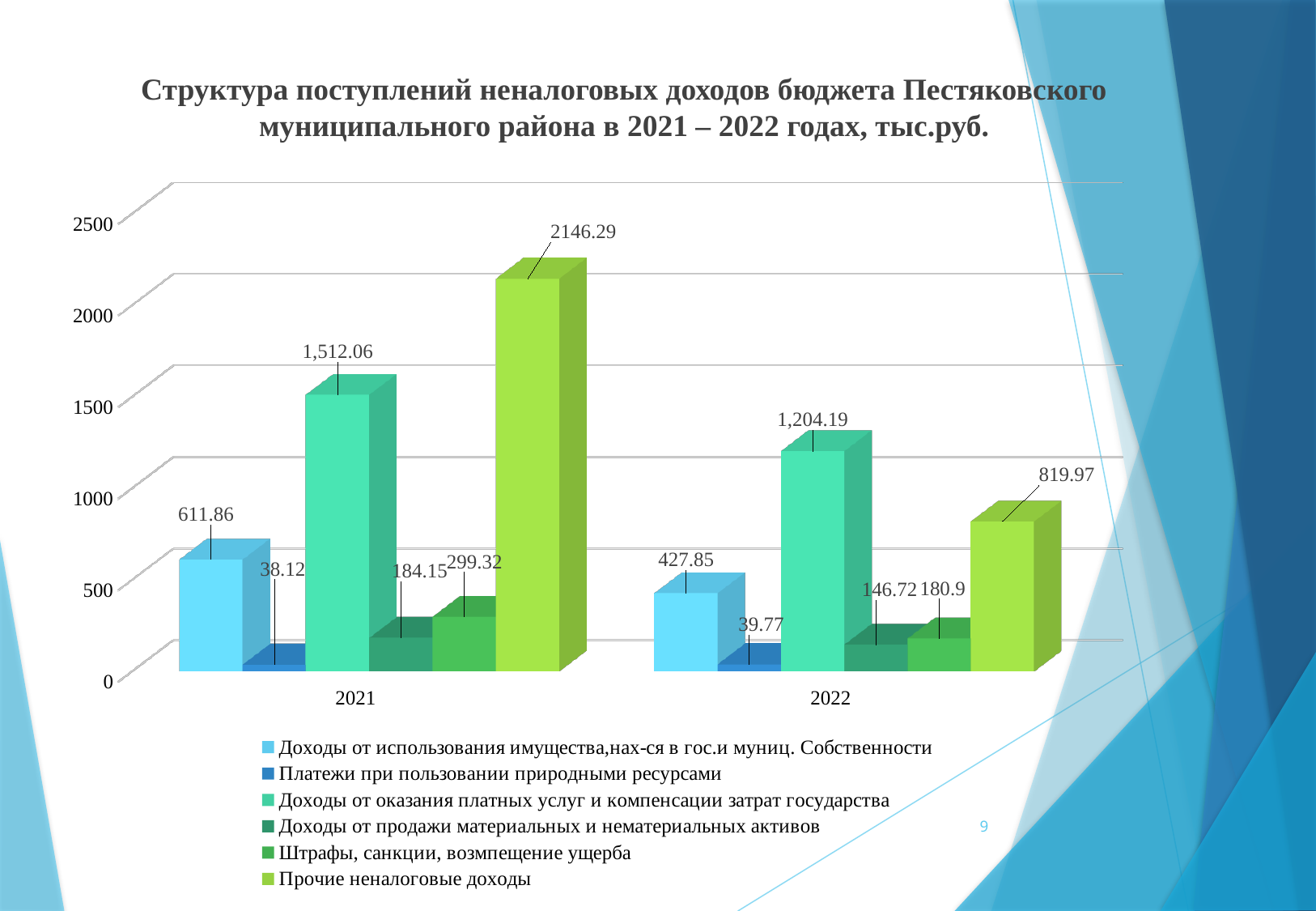
How many series does the legend list? 6 What is the value for "Доходы от оказания платных услуг и компенсации затрат государства" in 2022? 1,204.19 What is the value for "Штрафы, санкции, возмпещение ущерба" in 2022? 180.9 What is the value for "Платежи при пользовании природными ресурсами" in 2021? 38.12 Is the value for "Доходы от оказания платных услуг и компенсации затрат государства" in 2021 greater or less than 1500? greater How many year categories are shown on the x axis? 2 What kind of chart is shown on the slide? Bar chart Which series has the lowest value in 2021? Платежи при пользовании природными ресурсами What is the value for "Прочие неналоговые доходы" in 2021? 2146.29 What is the difference between the 2021 and 2022 values for "Доходы от использования имущества,нах-ся в гос.и муниц. Собственности"? 184.01 Which is larger: the value for "Прочие неналоговые доходы" in 2021 or in 2022? 2021 Which series has the highest value in 2022? Доходы от оказания платных услуг и компенсации затрат государства